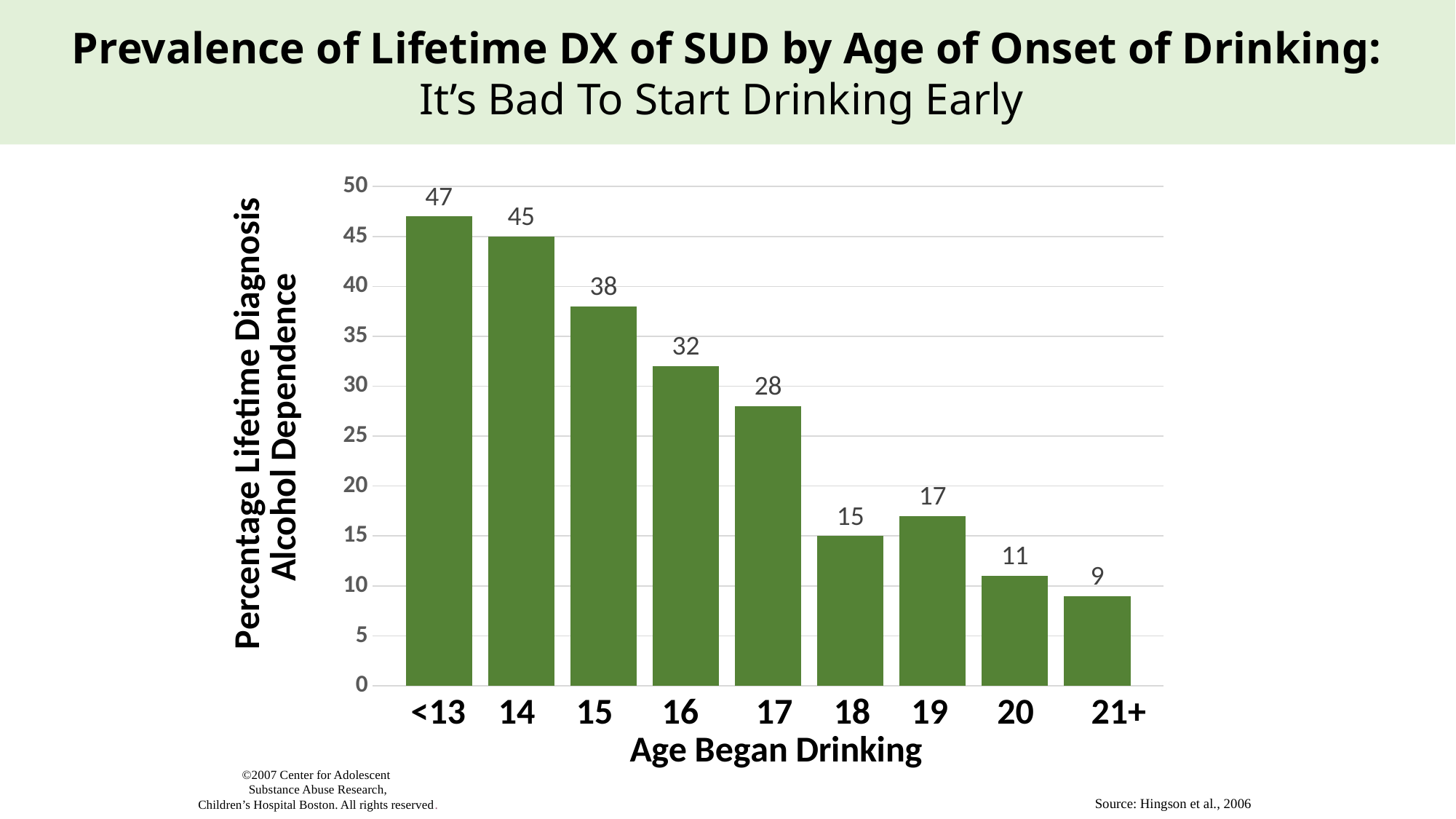
How many age groups are shown on the x axis? 9 What is the percentage lifetime diagnosis of alcohol dependence for those who began drinking at age 16? 32 Do the values generally rise or fall as the age of onset of drinking increases? Fall Which age group has the lowest percentage lifetime diagnosis of alcohol dependence? 21+ What is the difference between the values for the <13 group and the 21+ group? 38 What is the value shown for the 21+ age group? 9 What is the label of the x axis? Age Began Drinking What is the value shown for the <13 age group? 47 What is the difference between the values for age 15 and age 17? 10 Which age group has the highest percentage lifetime diagnosis of alcohol dependence? <13 What kind of chart is shown on the slide? Bar chart Which has a higher value, age 18 or age 19? 19